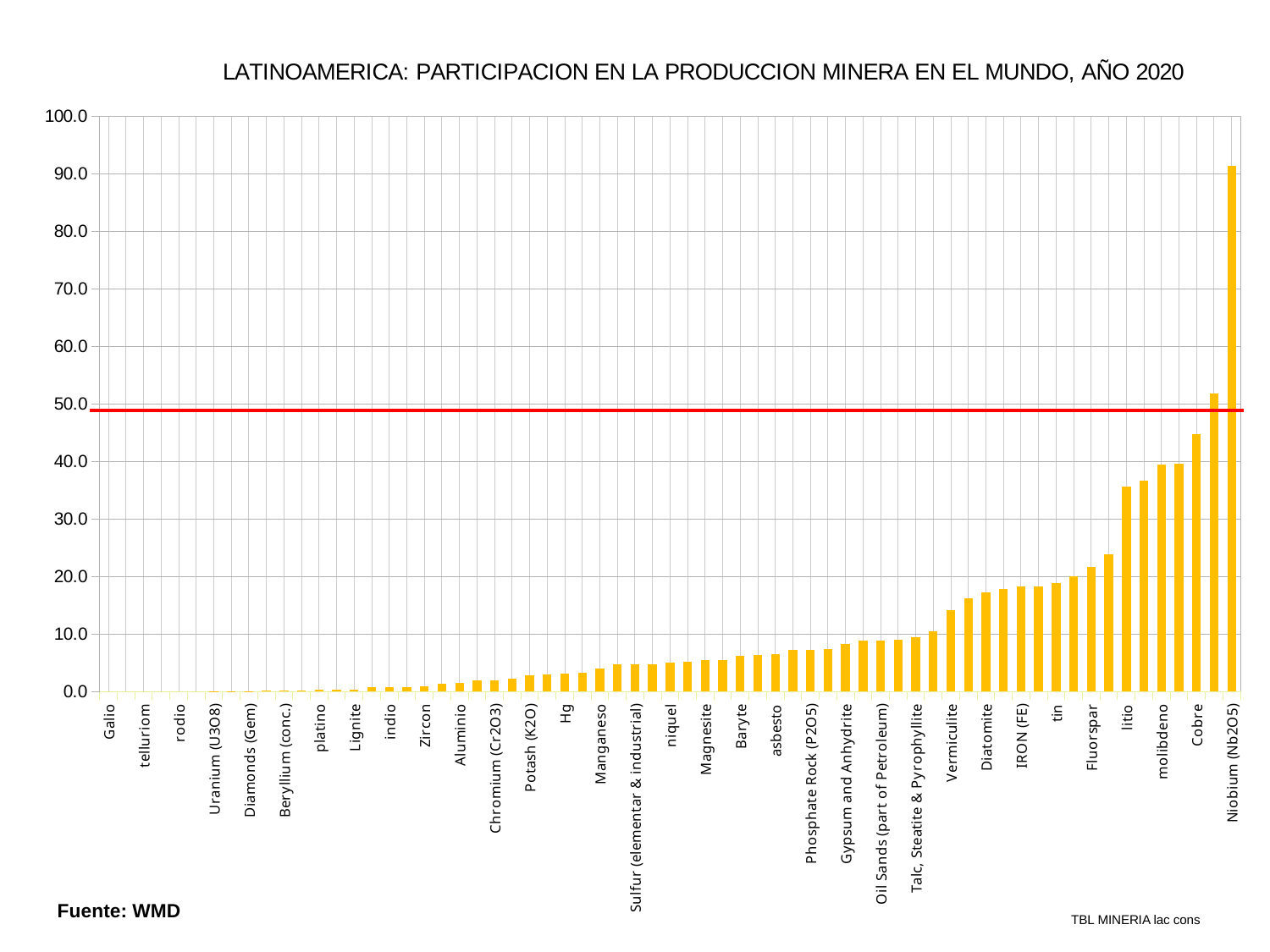
Do the bar values rise or fall from left to right along the x axis? rise Is the value for Fluorspar greater or less than 20? greater Which is larger, the value for Cobre or the value for litio? Cobre Is the value for litio greater or less than 40? less What colour is the horizontal reference line drawn across the chart? red Is the value for Cobre greater or less than 40? greater What kind of chart is shown on the slide? bar chart What is the title of the chart? LATINOAMERICA: PARTICIPACION EN LA PRODUCCION MINERA EN EL MUNDO, AÑO 2020 Which category has the highest value in the chart? Niobium (Nb2O5)